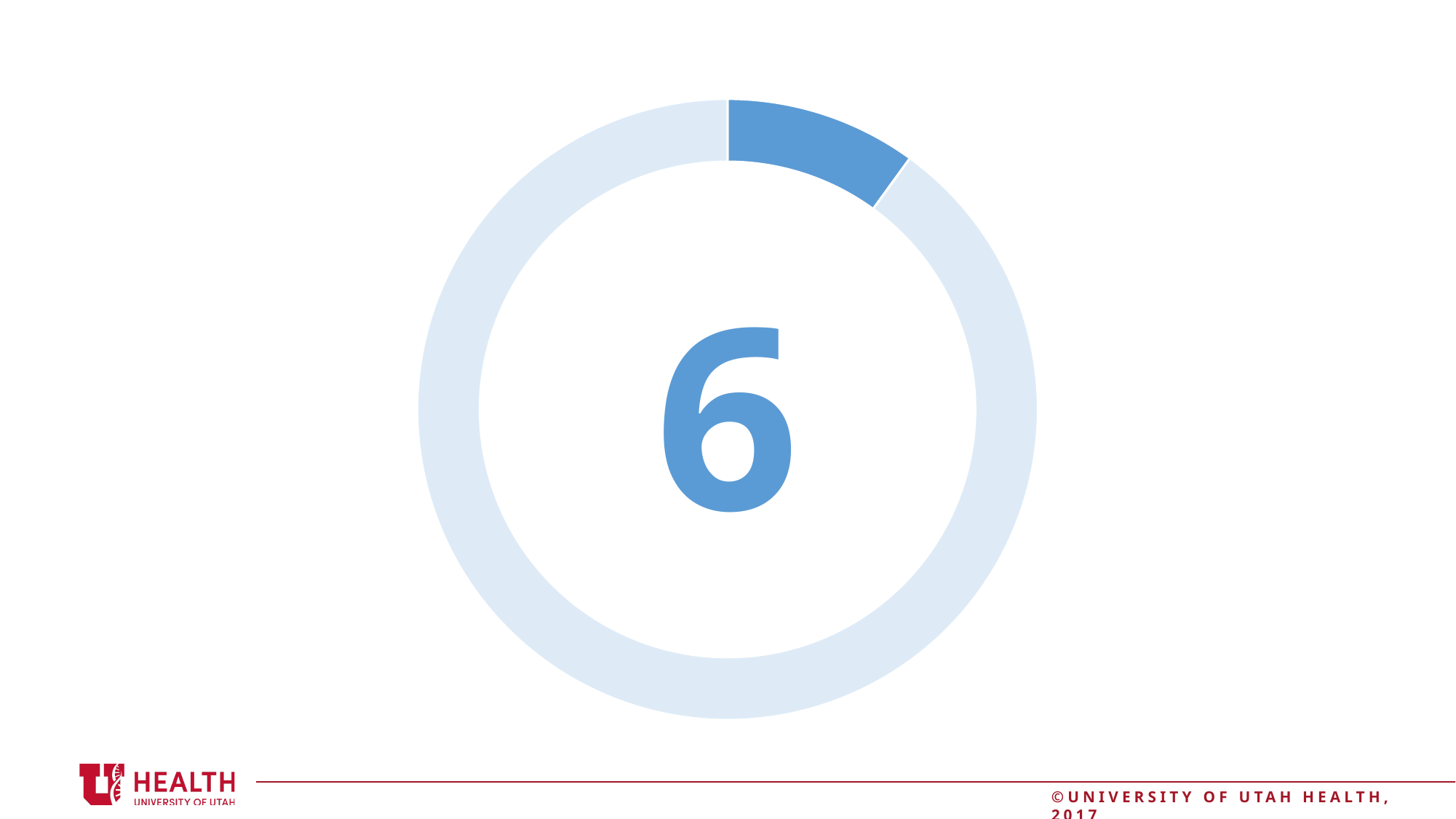
What kind of chart is shown on the slide? doughnut chart What number is printed in the centre of the doughnut chart? 6 What colour is the highlighted (smaller) segment of the doughnut chart? dark blue Which segment of the doughnut chart is larger, the dark blue one or the light blue one? the light blue one How many segments does the doughnut chart have? 2 Does the doughnut chart have a legend? No